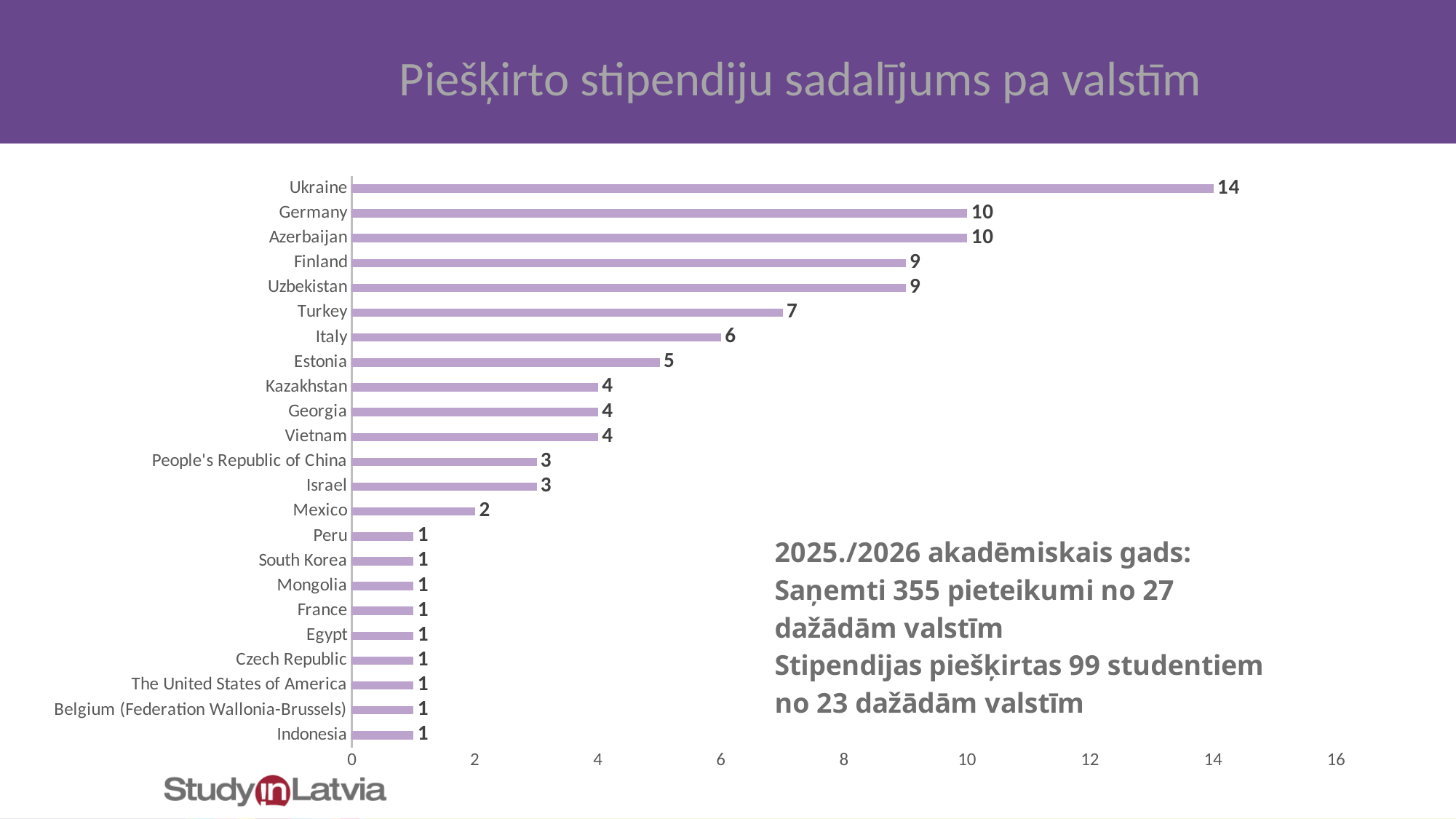
What is the value for Ukraine? 14 How many countries are shown in the chart? 23 What is the value for Turkey? 7 What is the difference between the values for Finland and Italy? 3 What kind of chart is shown on the slide? Bar chart What is the value for Mexico? 2 Which is larger, the value for Kazakhstan or the value for Israel? Kazakhstan Which country has the highest value? Ukraine What is the difference between the values for Ukraine and Germany? 4 What is the value for Estonia? 5 Which is larger, the value for Turkey or the value for Estonia? Turkey What is the title of the slide? Piešķirto stipendiju sadalījums pa valstīm